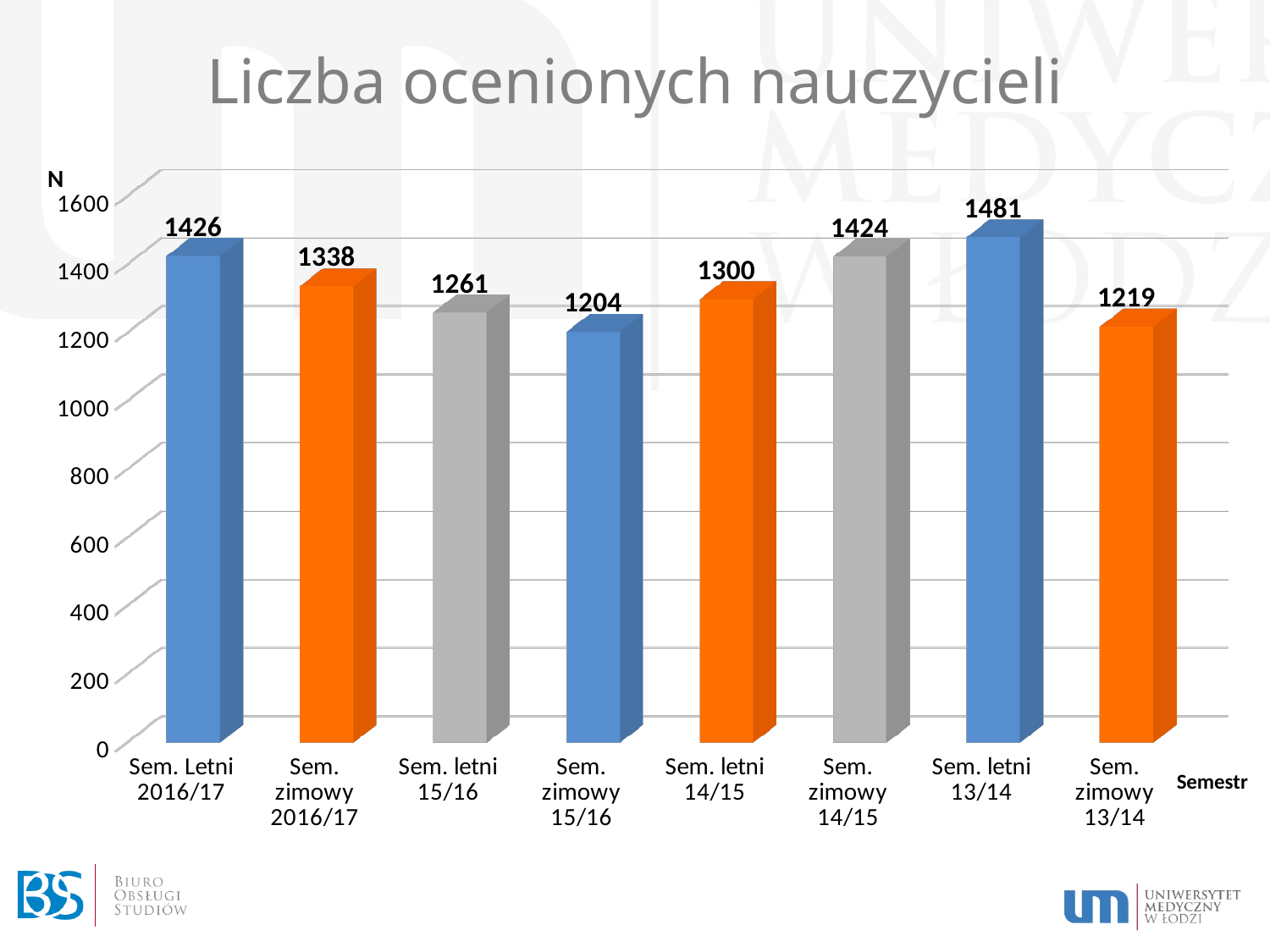
What is the value for Sem. letni 13/14? 1481 What is the difference between the values for Sem. letni 13/14 and Sem. zimowy 13/14? 262 Which semester has the lowest number of evaluated teachers? Sem. zimowy 15/16 Which semester has the highest number of evaluated teachers? Sem. letni 13/14 Which is larger, the value for Sem. letni 14/15 or Sem. zimowy 14/15? Sem. zimowy 14/15 What is the difference between the values for Sem. Letni 2016/17 and Sem. zimowy 2016/17? 88 Is the value for Sem. letni 15/16 greater or less than 1400? less What is the value for Sem. zimowy 15/16? 1204 How many semesters are shown on the chart? 8 What is the value for Sem. Letni 2016/17? 1426 What kind of chart is shown on the slide? bar chart What is the title of the chart? Liczba ocenionych nauczycieli